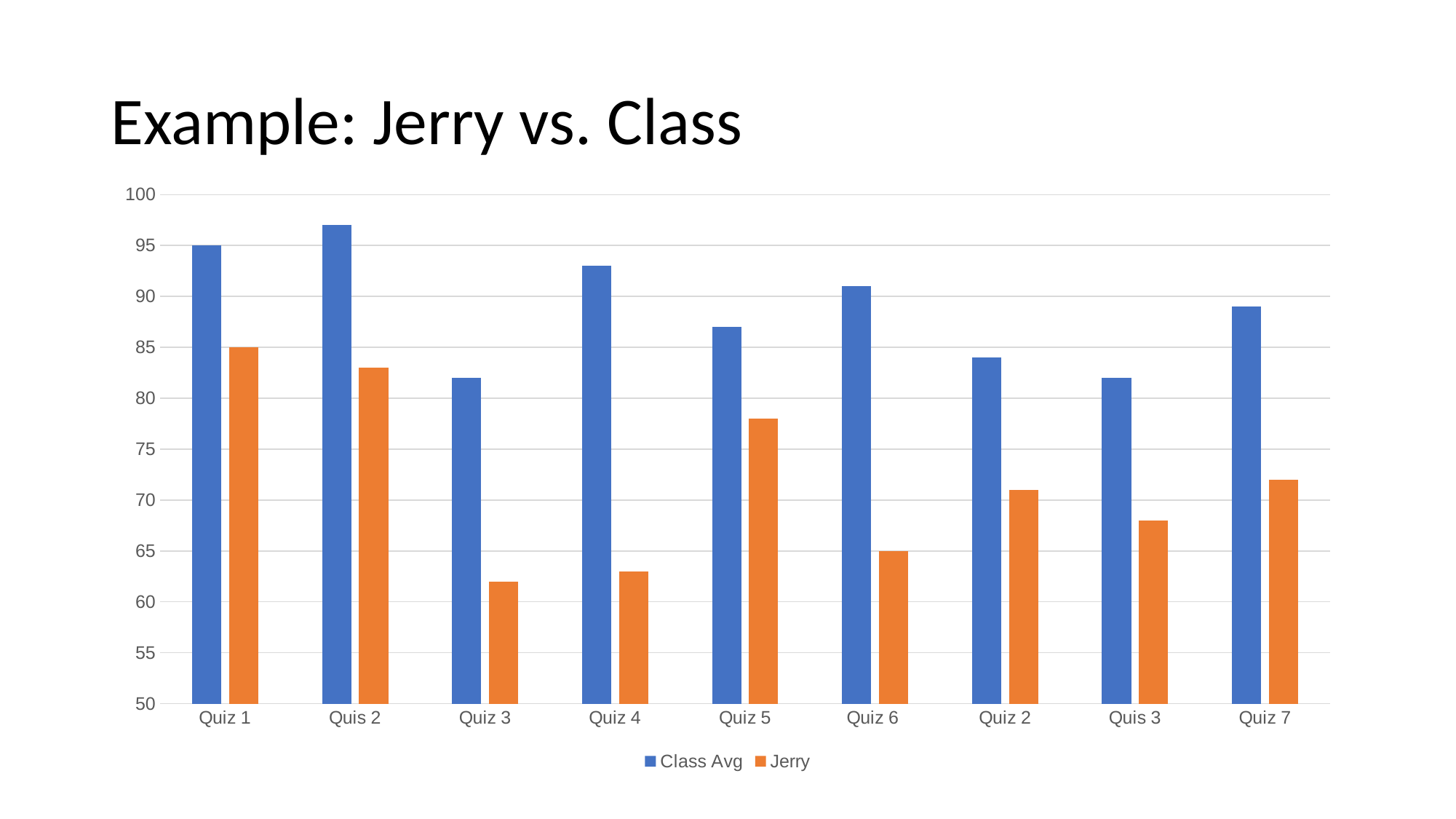
How many categories are shown on the x axis? 9 What is Jerry's value for Quiz 6? 65 What is Jerry's value for Quiz 1? 85 Which category has the highest Class Avg value? Quis 2 Is Jerry's value for Quiz 3 greater or less than 65? less Which category has the highest Jerry value? Quiz 1 What is the Class Avg value for Quiz 1? 95 How many series does the legend list? 2 What is the difference between the Class Avg and Jerry values for Quiz 1? 10 Which colour represents the Jerry series in the legend? orange Is the Class Avg value for Quiz 4 greater or less than 90? greater What type of chart is shown on the slide? bar chart